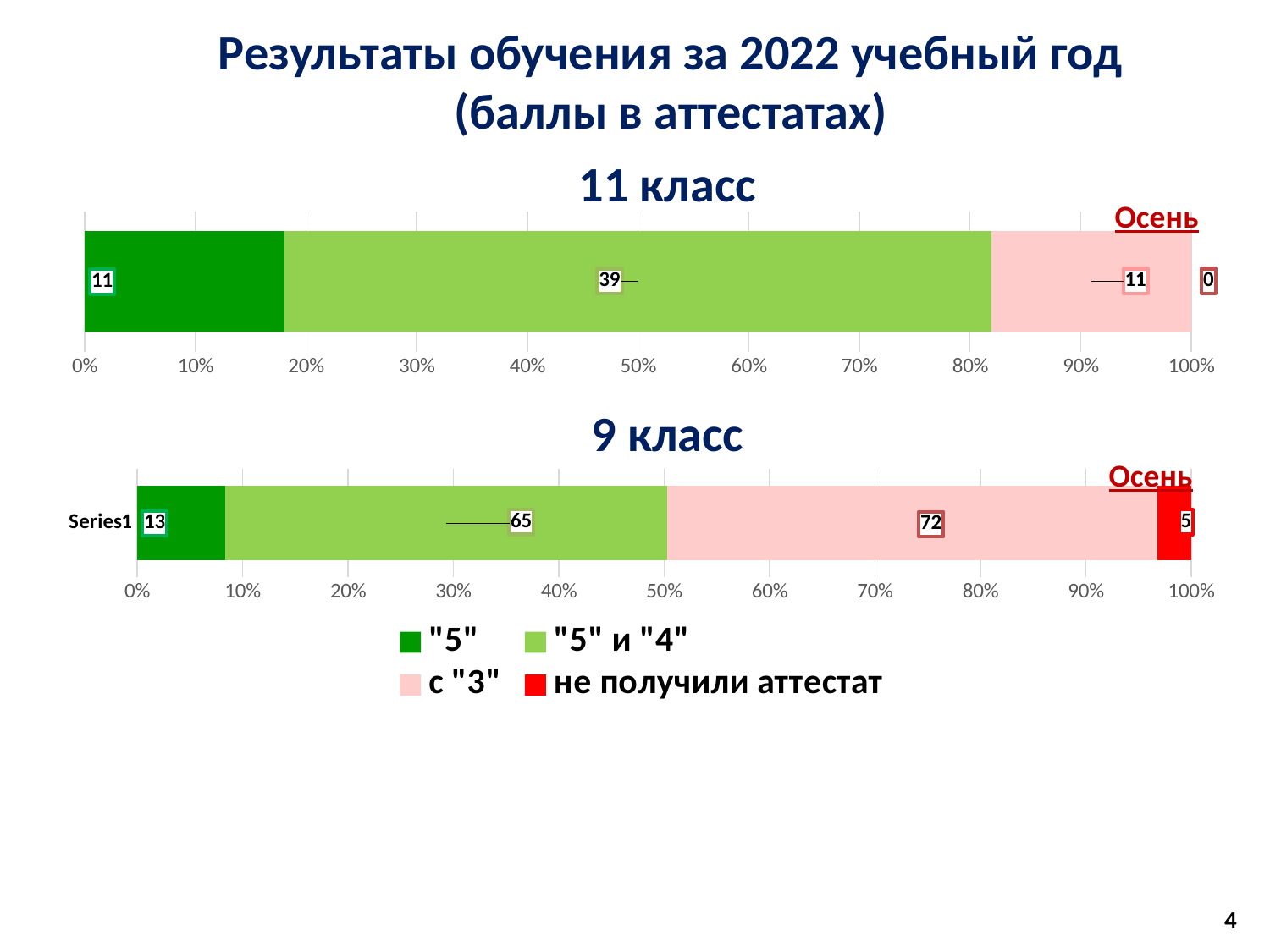
In the "9 класс" chart, what is the total of all segments in the stacked bar? 155 What kind of chart is the "9 класс" chart? Stacked bar chart In the "11 класс" chart, what is the value for the "5" segment? 11 In the "11 класс" chart, what is the value for the "не получили аттестат" segment? 0 In the "11 класс" chart, what is the total of all segments in the stacked bar? 61 In the "11 класс" chart, what is the value for the "5" и "4" segment? 39 In the "9 класс" chart, what is the value for the "не получили аттестат" segment? 5 In the "9 класс" chart, what is the difference between the "с "3"" value and the "5" и "4" value? 7 In the "9 класс" chart, which segment has the largest value? с "3" In the "11 класс" chart, which segment has the smallest value? не получили аттестат How many series does the legend list? 4 In the "9 класс" chart, what is the value for the "с "3"" segment? 72